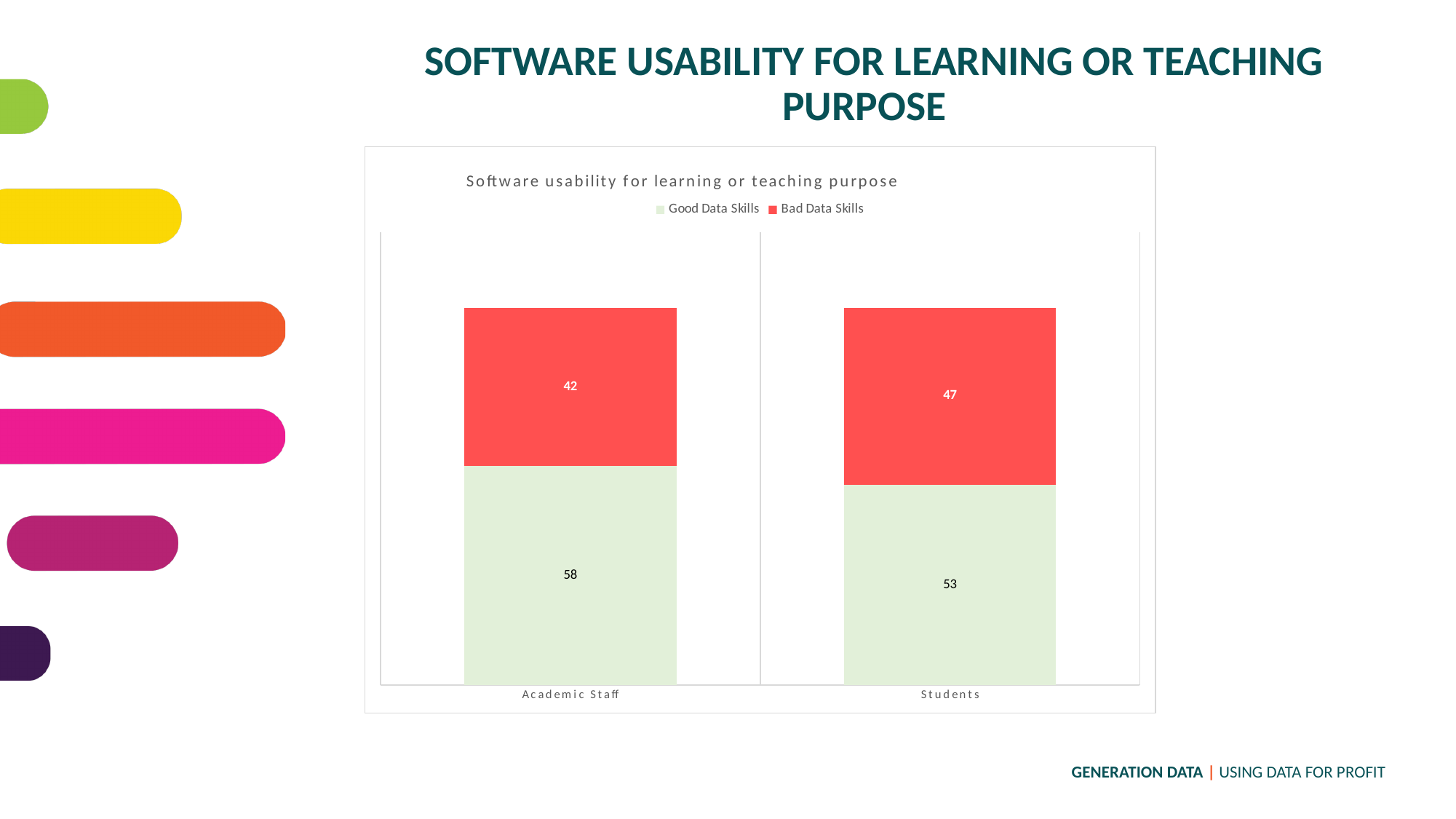
How many series does the legend list? 2 What is the difference between the Good Data Skills values for Academic Staff and Students? 5 Is the Bad Data Skills value larger for Academic Staff or for Students? Students What is the Good Data Skills value for Students? 53 What kind of chart is shown? Stacked bar chart What is the Bad Data Skills value for Academic Staff? 42 What is the total of the stacked bar for Students? 100 Which category has the lower Bad Data Skills value? Academic Staff What is the Bad Data Skills value for Students? 47 How many categories are shown on the x axis? 2 What is the Good Data Skills value for Academic Staff? 58 Which category has the higher Good Data Skills value? Academic Staff